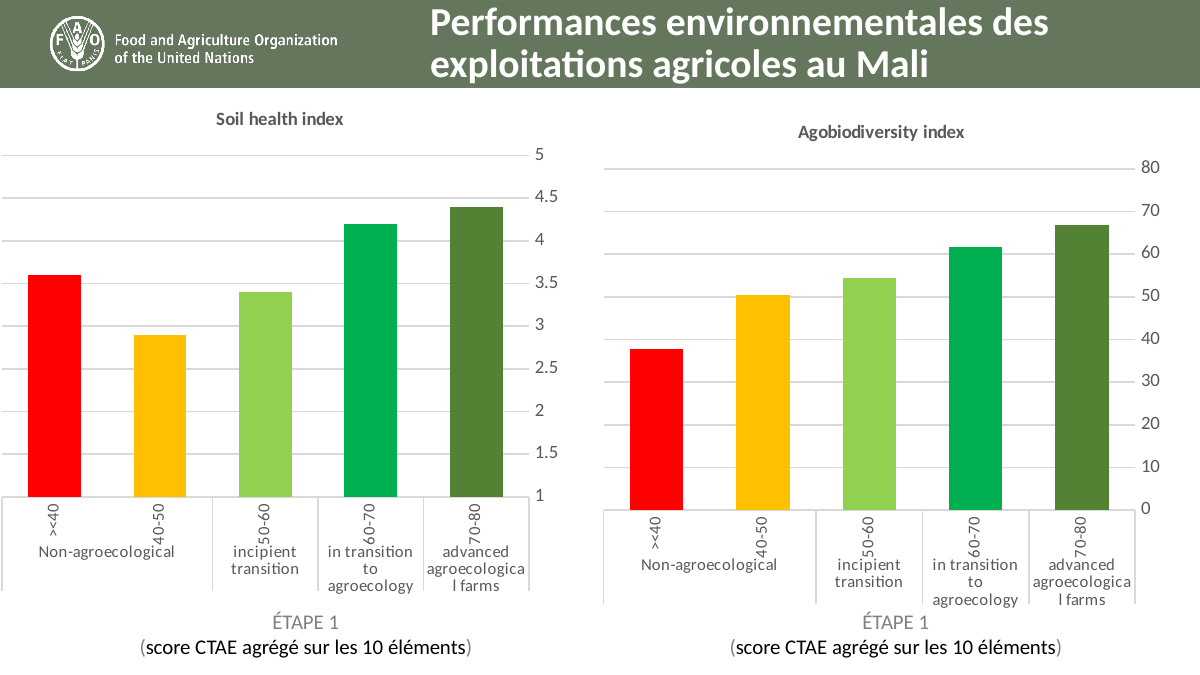
In the Soil health index chart, which category has the lowest value? 40-50 What kind of chart is the Soil health index chart? bar chart How many categories are shown in the Agobiodiversity index chart? 5 In the Soil health index chart, which is larger, the value for <40 or the value for 40-50? <40 In the Agobiodiversity index chart, which category has the highest value? 70-80 (advanced agroecological farms) In the Soil health index chart, which category has the highest value? 70-80 (advanced agroecological farms) In the Agobiodiversity index chart, which is larger, the value for 50-60 or the value for 60-70? 60-70 In the Agobiodiversity index chart, is the value for 70-80 greater or less than 70? less In the Agobiodiversity index chart, which category has the lowest value? <40 (Non-agroecological) In the Agobiodiversity index chart, do the values rise or fall from left to right along the x axis? rise In the Soil health index chart, is the value for 40-50 greater or less than 3? less In the Soil health index chart, is the value for 60-70 (in transition to agroecology) greater or less than 4? greater